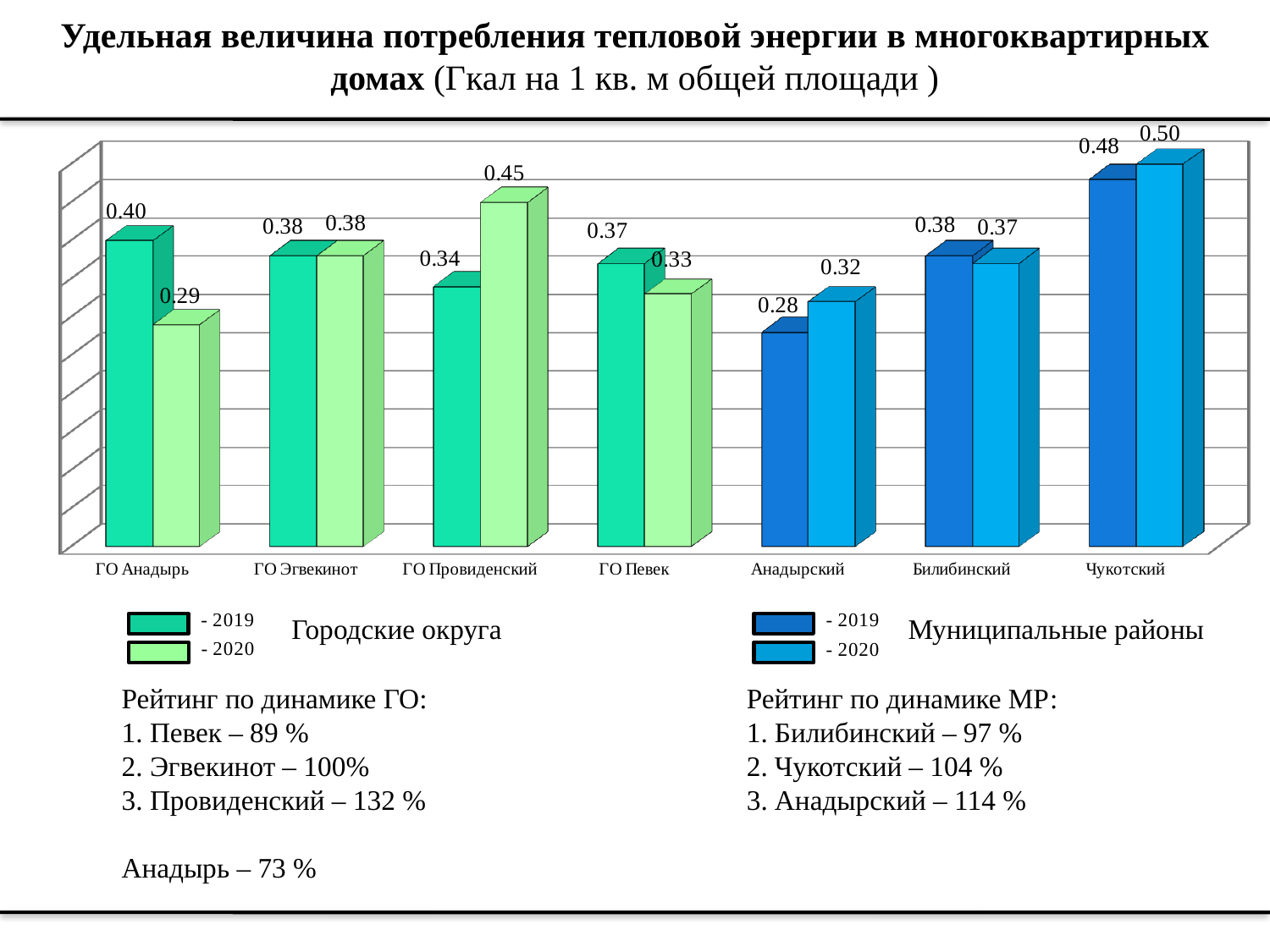
What is the difference between the 2019 and 2020 values for ГО Анадырь? 0.11 What is the 2019 value for ГО Анадырь? 0.40 Which category has the lowest 2019 value? Анадырский Which is larger: the 2019 value for ГО Певек or the 2020 value for ГО Певек? 2019 value for ГО Певек How many categories are shown on the x axis of the chart? 7 What is the difference between the 2020 values for Чукотский and ГО Певек? 0.17 What is the 2020 value for Анадырский? 0.32 What is the 2020 value for ГО Провиденский? 0.45 Which two years are compared in the chart legend? 2019 and 2020 Which category has the highest 2020 value? Чукотский What kind of chart is shown on the slide? bar chart Which group of categories is shown in blue bars? Муниципальные районы